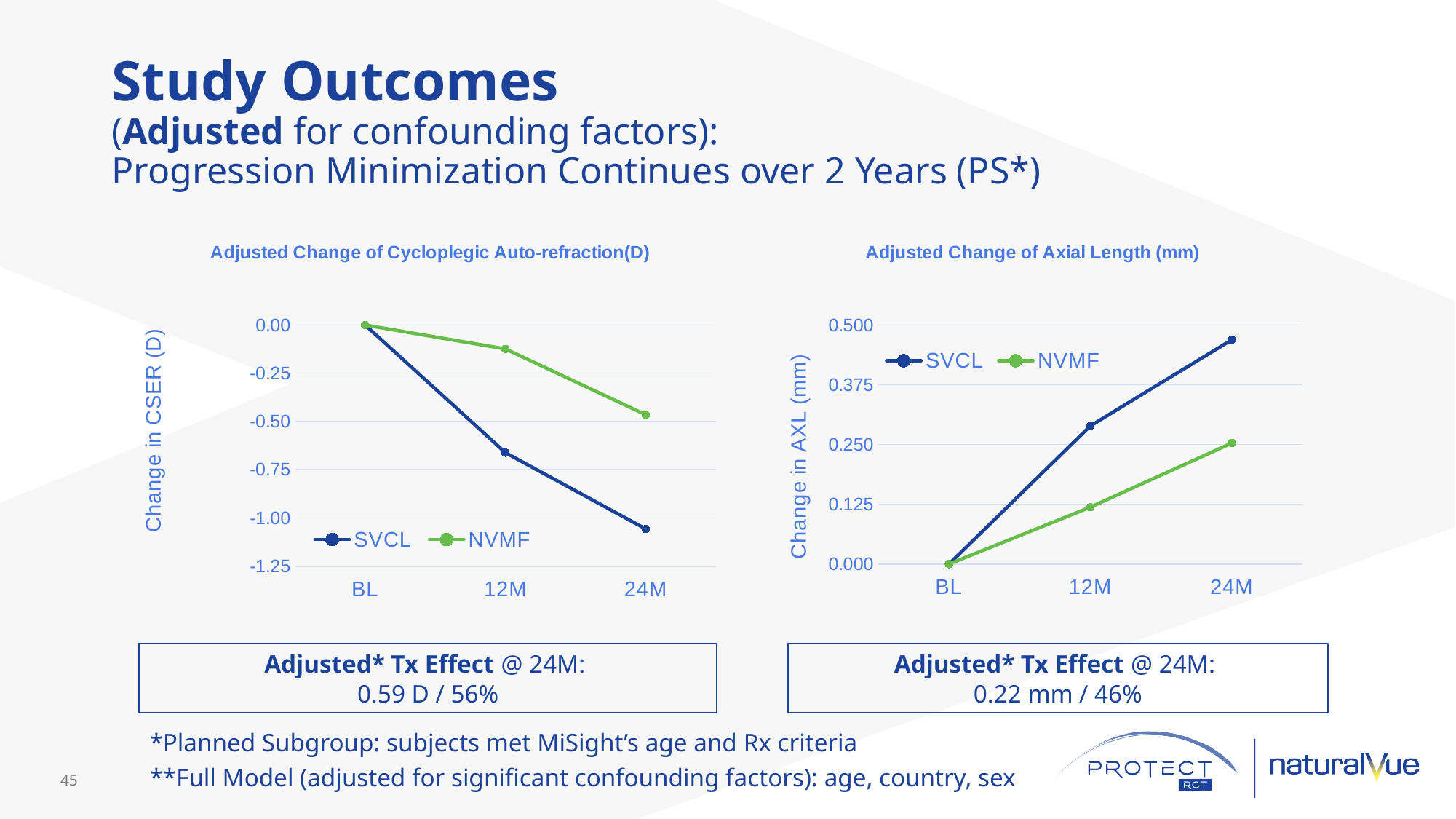
In the 'Adjusted Change of Axial Length (mm)' chart, do the NVMF values rise or fall from BL to 24M? rise In the 'Adjusted Change of Cycloplegic Auto-refraction(D)' chart, do the SVCL values rise or fall from BL to 24M? fall In the 'Adjusted Change of Cycloplegic Auto-refraction(D)' chart, what is the value for SVCL at BL? 0.00 How many time points are plotted along the x axis of the 'Adjusted Change of Cycloplegic Auto-refraction(D)' chart? 3 In the 'Adjusted Change of Cycloplegic Auto-refraction(D)' chart, is the value for SVCL at 24M greater or less than -1.00? less In the 'Adjusted Change of Cycloplegic Auto-refraction(D)' chart, is the value for NVMF at 24M greater or less than -0.25? less In the 'Adjusted Change of Axial Length (mm)' chart, is the value for SVCL at 24M greater or less than 0.375? greater In the 'Adjusted Change of Axial Length (mm)' chart, which series has the higher value at 24M, SVCL or NVMF? SVCL What kind of chart is the 'Adjusted Change of Cycloplegic Auto-refraction(D)' chart? line chart In the 'Adjusted Change of Axial Length (mm)' chart, what is the value for NVMF at BL? 0.000 In the 'Adjusted Change of Cycloplegic Auto-refraction(D)' chart, which series has the lower value at 24M, SVCL or NVMF? SVCL How many series does the legend of the 'Adjusted Change of Axial Length (mm)' chart list? 2